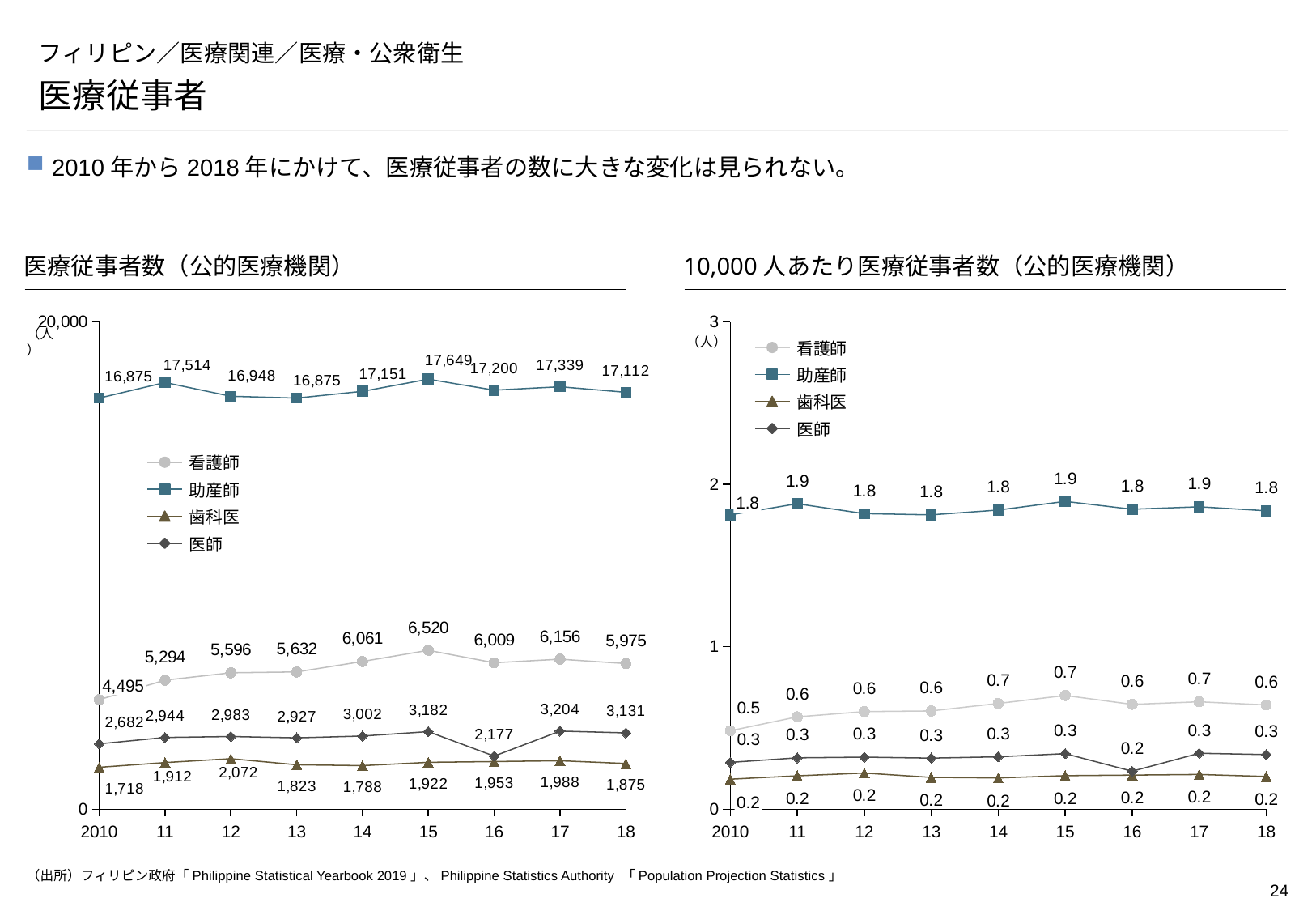
How many series does the legend of the left chart (医療従事者数（公的医療機関）) list? 4 In the left chart (医療従事者数（公的医療機関）), what is the value for 医師 in 2016? 2,177 In the left chart (医療従事者数（公的医療機関）), what is the value for 看護師 in 2010? 4,495 How many years are plotted on the x axis of the right chart (10,000人あたり医療従事者数（公的医療機関）)? 9 In the left chart (医療従事者数（公的医療機関）), in which year is the 歯科医 value lowest? 2010 In the left chart (医療従事者数（公的医療機関）), what is the difference between the 助産師 values in 2011 and 2010? 639 In the right chart (10,000人あたり医療従事者数（公的医療機関）), what is the value for 看護師 in 2014? 0.7 In the right chart (10,000人あたり医療従事者数（公的医療機関）), what is the value for 医師 in 2016? 0.2 What kind of chart is the right chart (10,000人あたり医療従事者数（公的医療機関）)? Line chart In the left chart (医療従事者数（公的医療機関）), which is larger: the 医師 value in 2017 or in 2018? 2017 In the left chart (医療従事者数（公的医療機関）), in which year is the 看護師 value highest? 2015 In the left chart (医療従事者数（公的医療機関）), what is the value for 助産師 in 2015? 17,649